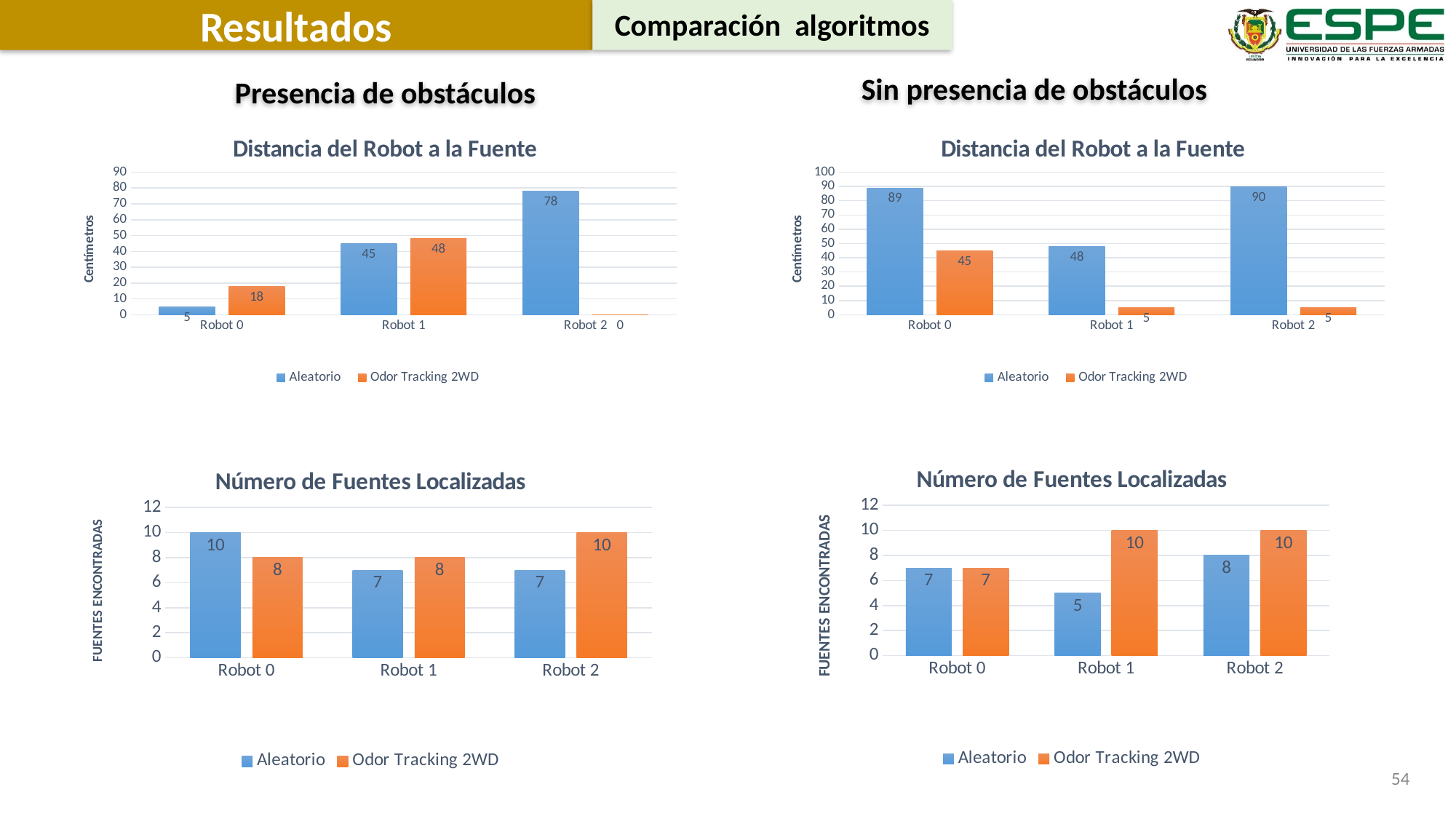
In the top-left chart (Distancia del Robot a la Fuente, Presencia de obstáculos), what is the Odor Tracking 2WD value for Robot 0? 18 What kind of chart is the top-left chart (Distancia del Robot a la Fuente, Presencia de obstáculos)? Bar chart In the bottom-left chart (Número de Fuentes Localizadas, Presencia de obstáculos), which is larger for Robot 2: Aleatorio or Odor Tracking 2WD? Odor Tracking 2WD In the bottom-right chart (Número de Fuentes Localizadas, Sin presencia de obstáculos), which robot has the lowest Aleatorio value? Robot 1 In the top-right chart (Distancia del Robot a la Fuente, Sin presencia de obstáculos), what is the Odor Tracking 2WD value for Robot 0? 45 In the top-left chart (Distancia del Robot a la Fuente, Presencia de obstáculos), what is the difference between the Odor Tracking 2WD and Aleatorio values for Robot 1? 3 In the bottom-right chart (Número de Fuentes Localizadas, Sin presencia de obstáculos), what is the Odor Tracking 2WD value for Robot 1? 10 In the top-left chart (Distancia del Robot a la Fuente, Presencia de obstáculos), what is the Aleatorio value for Robot 2? 78 In the top-right chart (Distancia del Robot a la Fuente, Sin presencia de obstáculos), what is the difference between the Aleatorio and Odor Tracking 2WD values for Robot 0? 44 In the bottom-left chart (Número de Fuentes Localizadas, Presencia de obstáculos), what is the Aleatorio value for Robot 0? 10 In the top-right chart (Distancia del Robot a la Fuente, Sin presencia de obstáculos), which robot has the highest Aleatorio value? Robot 2 How many series does the legend of the bottom-right chart (Número de Fuentes Localizadas, Sin presencia de obstáculos) list? 2